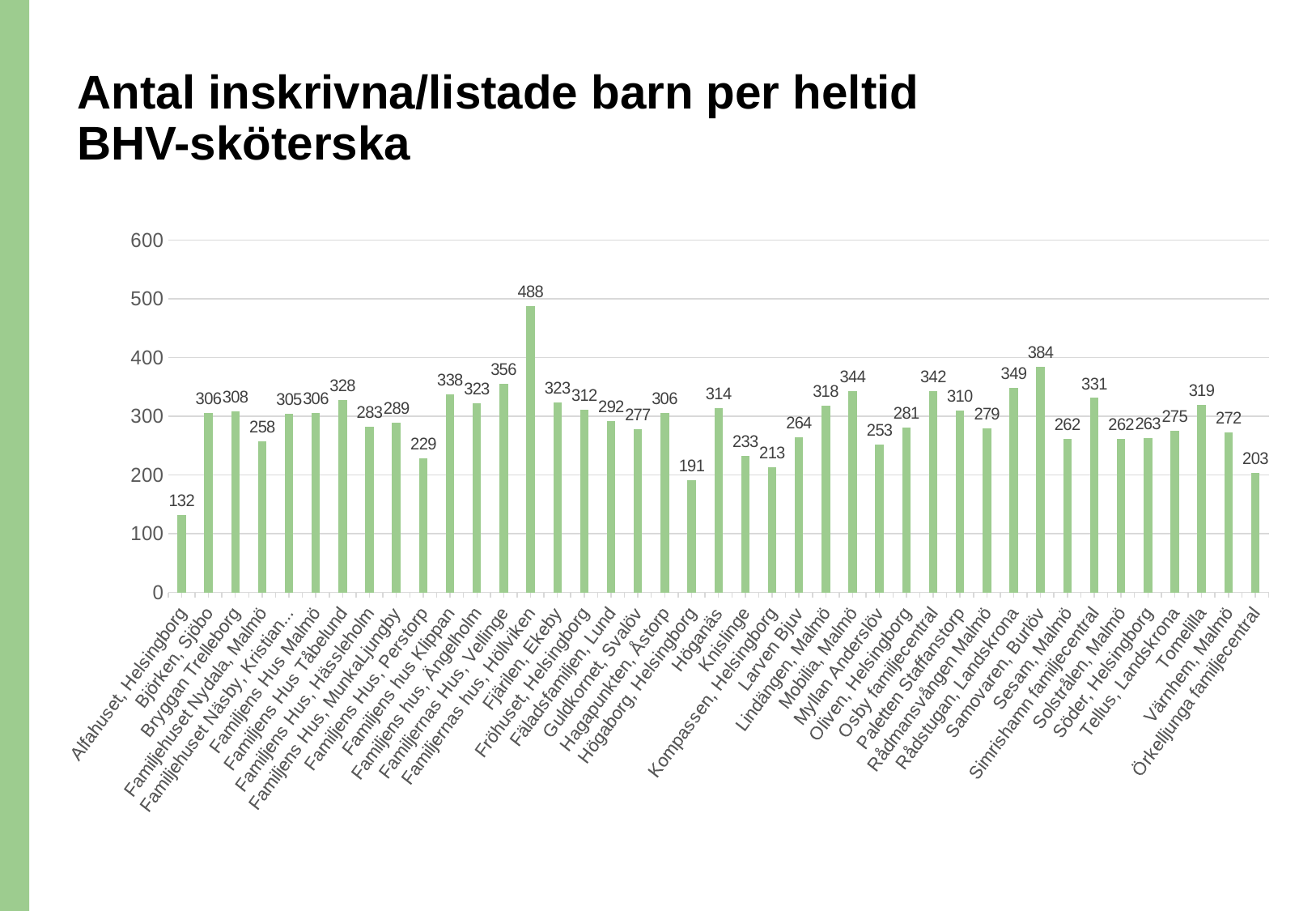
What is the value for Familjernas hus, Höllviken? 488 What is the difference between the values for Mobilia, Malmö and Myllan Anderslöv? 91 What is the value for Samovaren, Burlöv? 384 Which category has the lowest value? Alfahuset, Helsingborg What is the difference between the values for Familjernas hus, Höllviken and Alfahuset, Helsingborg? 356 Which is larger, the value for Rådstugan, Landskrona or the value for Tellus, Landskrona? Rådstugan, Landskrona What is the value for Kompassen, Helsingborg? 213 How many categories are shown on the x axis? 41 Is the value for Högaborg, Helsingborg greater or less than 200? less What kind of chart is shown on the slide? bar chart What is the title of the chart on the slide? Antal inskrivna/listade barn per heltid BHV-sköterska Which category has the highest value? Familjernas hus, Höllviken